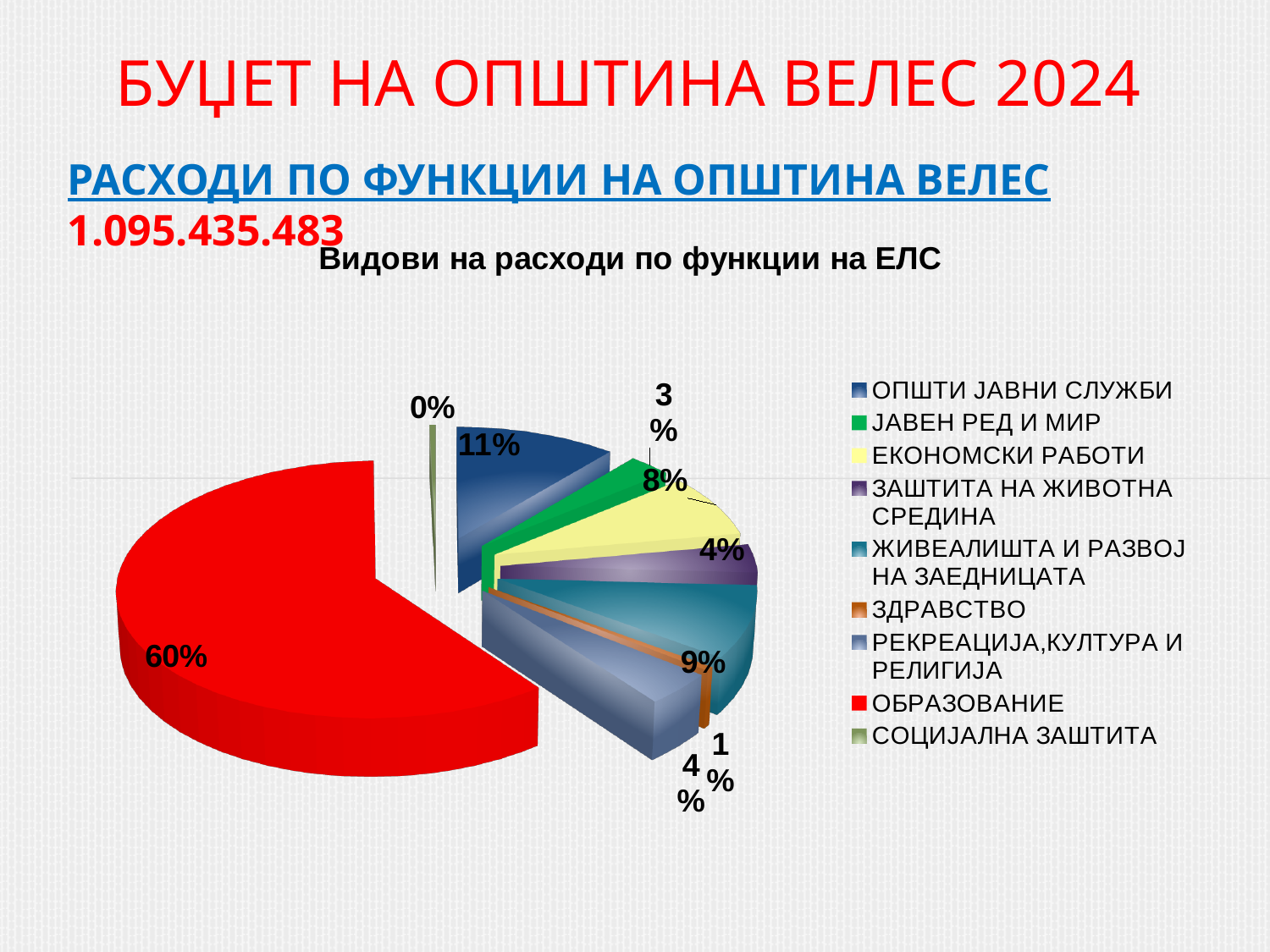
What share of the pie is ЗДРАВСТВО? 1% Which is larger, the slice for ЈАВЕН РЕД И МИР or the slice for ЗАШТИТА НА ЖИВОТНА СРЕДИНА? ЗАШТИТА НА ЖИВОТНА СРЕДИНА How many categories does the legend list? 9 What share of the pie is ЖИВЕАЛИШТА И РАЗВОЈ НА ЗАЕДНИЦАТА? 9% What is the chart's title? Видови на расходи по функции на ЕЛС What share of the pie is ОБРАЗОВАНИЕ? 60% Which category has the largest slice of the pie? ОБРАЗОВАНИЕ What kind of chart is shown on the slide? pie chart Which category has the smallest slice of the pie? СОЦИЈАЛНА ЗАШТИТА What share of the pie is ЕКОНОМСКИ РАБОТИ? 8% What share of the pie is ОПШТИ ЈАВНИ СЛУЖБИ? 11% What is the difference in percentage points between the ОБРАЗОВАНИЕ slice and the ОПШТИ ЈАВНИ СЛУЖБИ slice? 49 percentage points